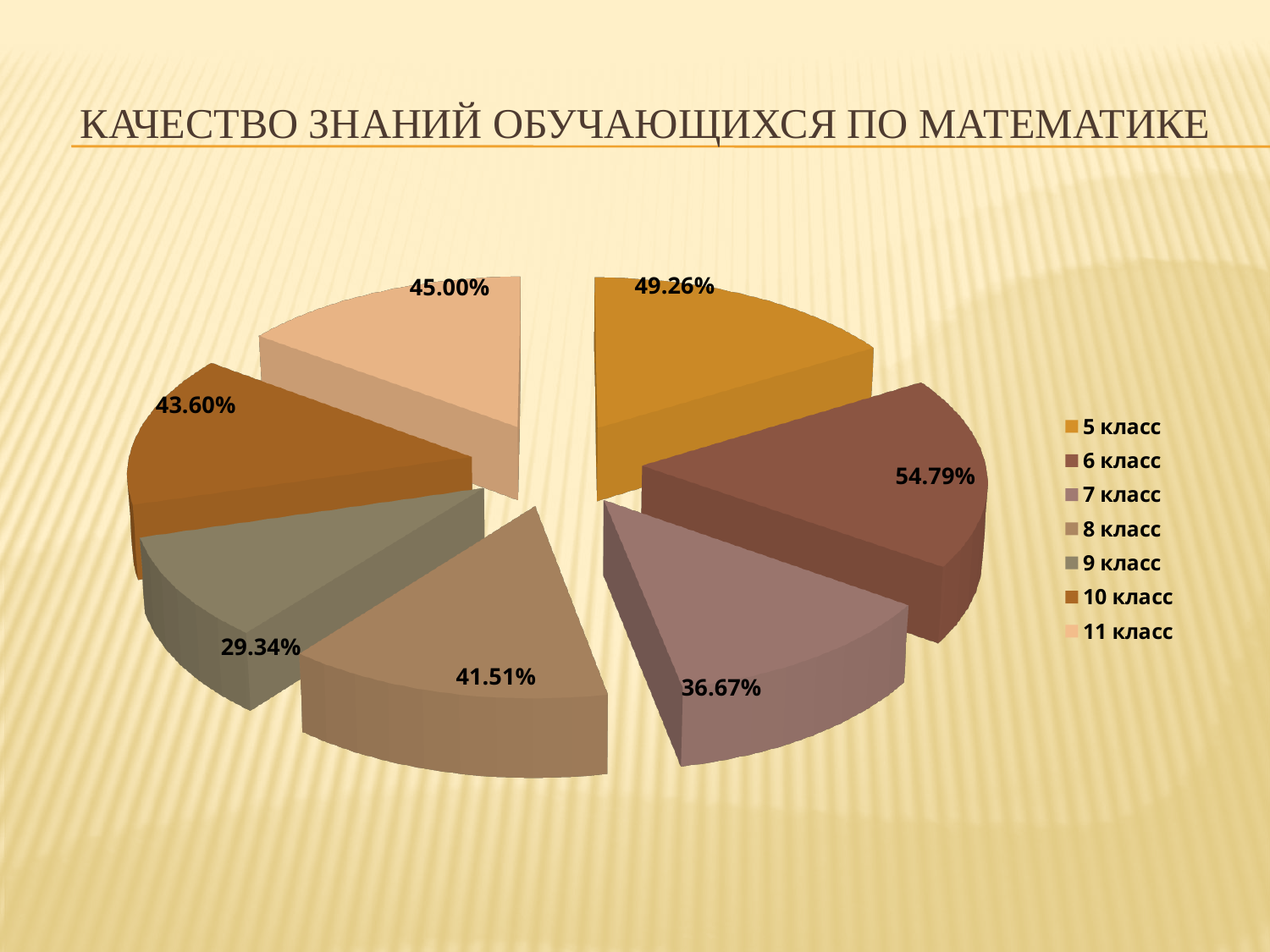
Which has a larger value, 7 класс or 8 класс? 8 класс How many entries does the legend list? 7 What is the value shown for 9 класс? 29.34% What is the value shown for 6 класс? 54.79% How many slices does the pie chart have? 7 Which class has the highest value in the chart? 6 класс What is the title of the slide? КАЧЕСТВО ЗНАНИЙ ОБУЧАЮЩИХСЯ ПО МАТЕМАТИКЕ What is the value shown for 5 класс? 49.26% What kind of chart is shown on the slide? Pie chart Which class has the lowest value in the chart? 9 класс What is the difference between the values for 6 класс and 9 класс? 25.45% What is the value shown for 11 класс? 45.00%